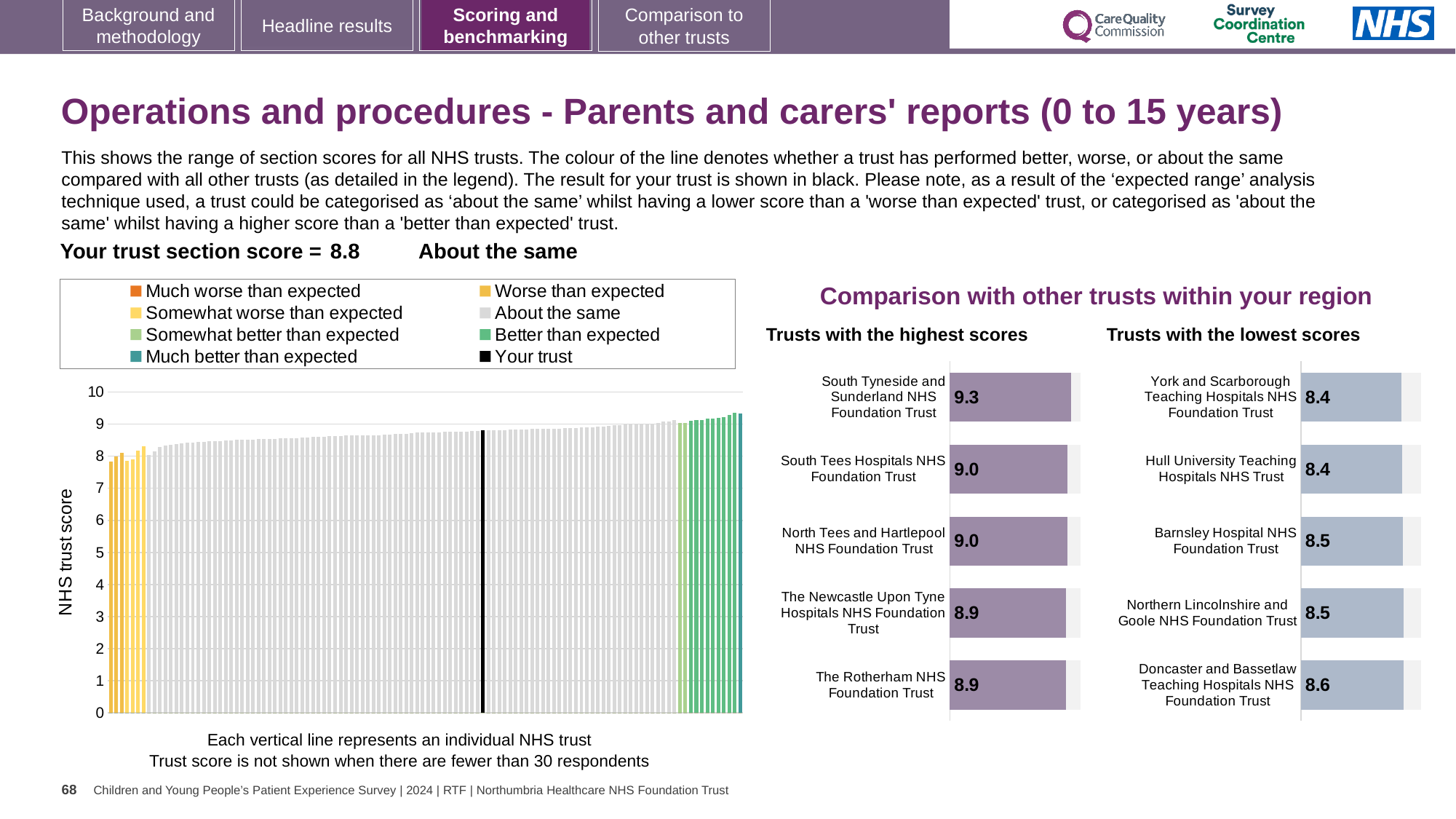
In the 'Trusts with the highest scores' chart, which trust has the highest score? South Tyneside and Sunderland NHS Foundation Trust How many trusts are shown in the 'Trusts with the highest scores' chart? 5 In the 'Trusts with the highest scores' chart, what is the difference between the scores of South Tyneside and Sunderland NHS Foundation Trust and The Rotherham NHS Foundation Trust? 0.4 In the 'Trusts with the lowest scores' chart, which trust has the highest score? Doncaster and Bassetlaw Teaching Hospitals NHS Foundation Trust In the 'Trusts with the lowest scores' chart, which has the larger score: Barnsley Hospital NHS Foundation Trust or Doncaster and Bassetlaw Teaching Hospitals NHS Foundation Trust? Doncaster and Bassetlaw Teaching Hospitals NHS Foundation Trust In the 'Trusts with the lowest scores' chart, what is the score for Doncaster and Bassetlaw Teaching Hospitals NHS Foundation Trust? 8.6 What is the section score for your trust shown on the slide? 8.8 How many entries does the legend of the 'NHS trust score' chart on the left list? 8 In the 'Trusts with the lowest scores' chart, what is the difference between the scores of Doncaster and Bassetlaw Teaching Hospitals NHS Foundation Trust and York and Scarborough Teaching Hospitals NHS Foundation Trust? 0.2 What kind of chart is the 'NHS trust score' chart on the left of the slide? bar chart In the 'Trusts with the highest scores' chart, what is the score for South Tyneside and Sunderland NHS Foundation Trust? 9.3 In the 'NHS trust score' chart on the left, do the bar values rise or fall from left to right? rise